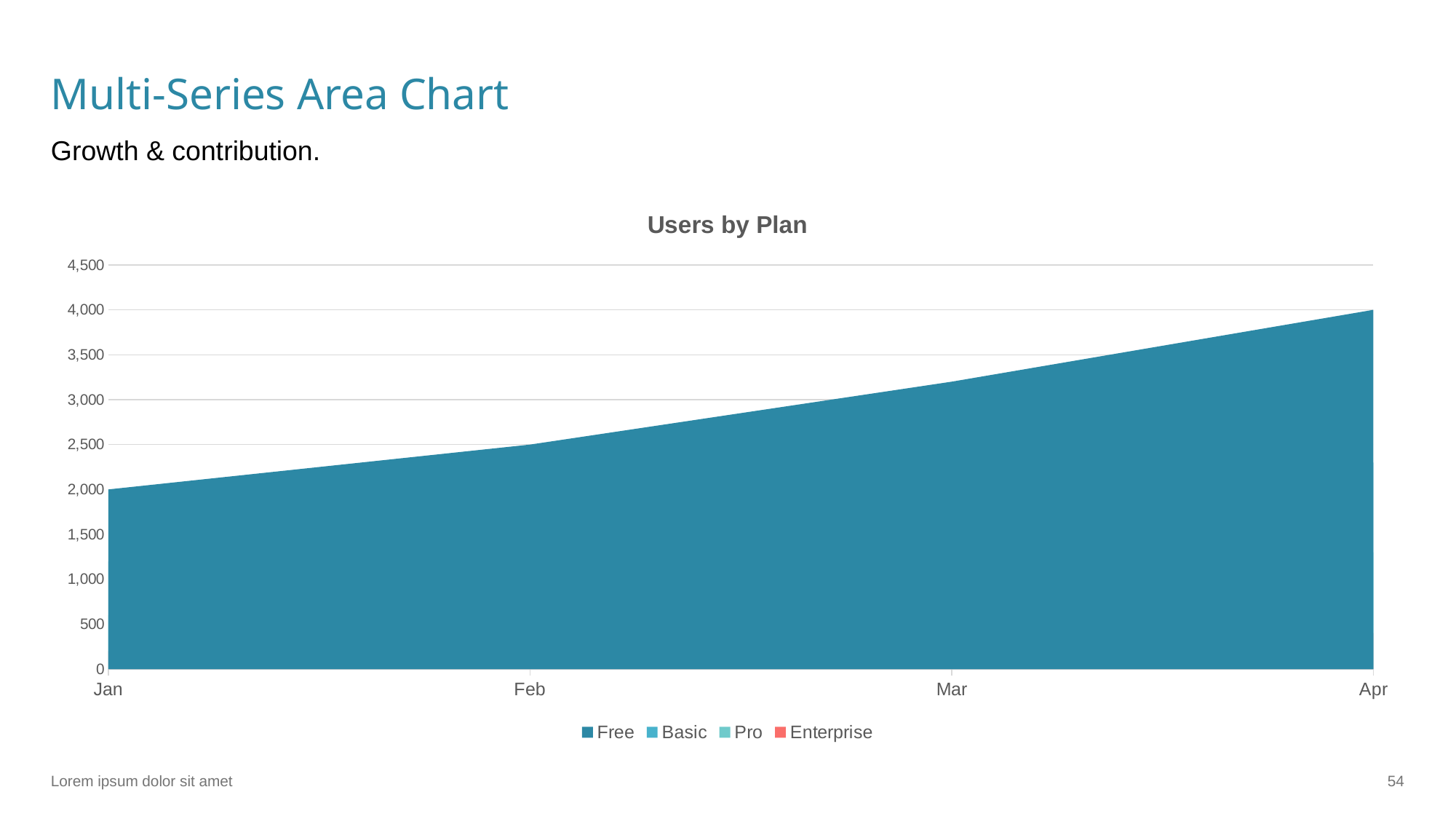
What is the title of the chart? Users by Plan Which month has the highest value? Apr How many months are shown on the x axis? 4 Which month has the lowest value? Jan What kind of chart is shown on the slide? Area chart What is the value of the visible area in Feb? 2,500 What is the value of the visible area in Apr? 4,000 Is the value for Mar greater or less than 3,000? greater Do the values rise or fall from Jan to Apr? Rise How many series does the legend list? 4 What is the value of the visible area in Jan? 2,000 What is the difference between the Apr value and the Jan value? 2,000